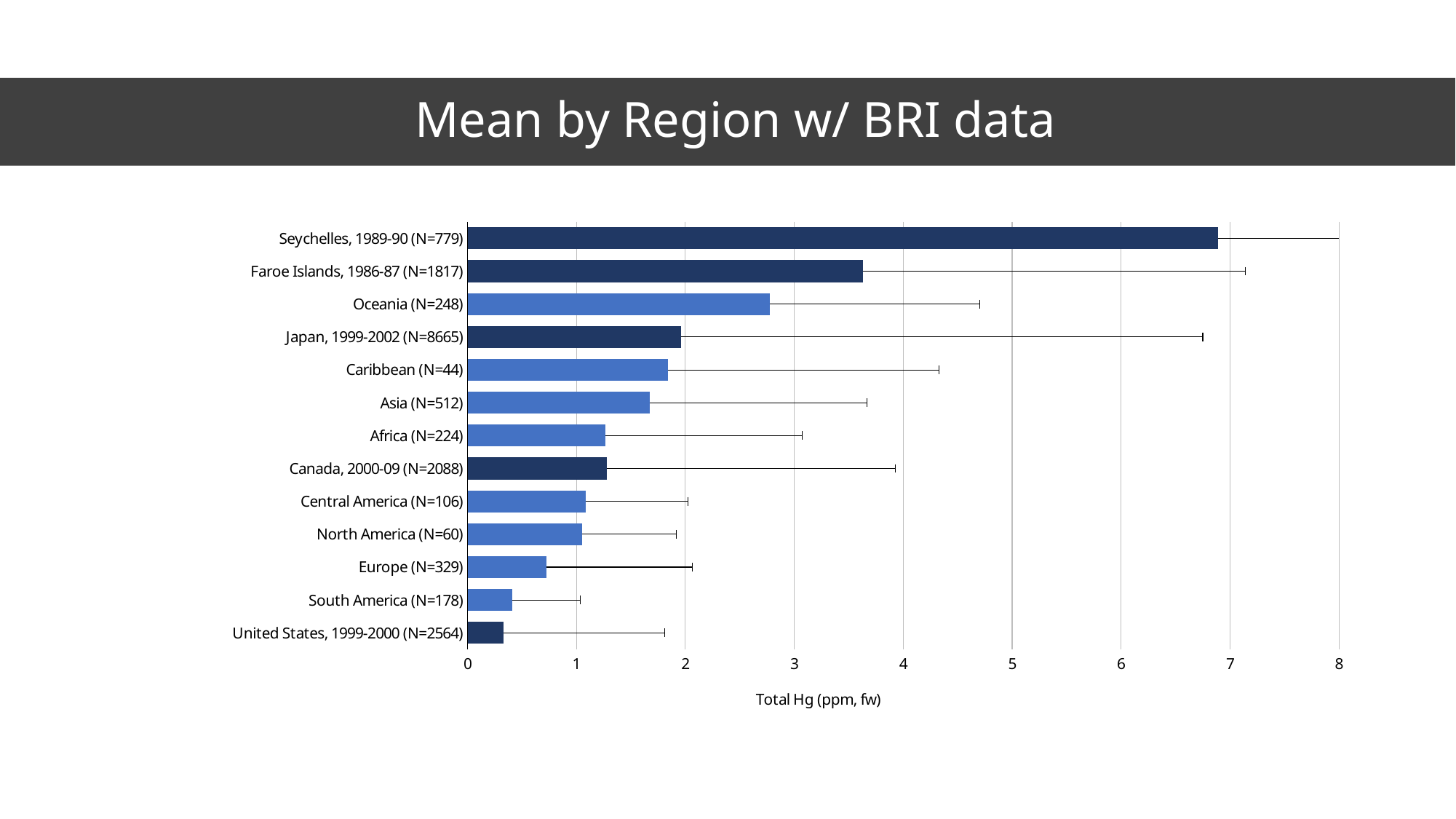
Which region has the lowest mean Total Hg? United States, 1999-2000 (N=2564) What kind of chart is shown on the slide? bar chart Is the value for Asia (N=512) greater or less than 1? greater Is the value for Oceania (N=248) greater or less than 3? less Which has a larger mean Total Hg, Europe (N=329) or South America (N=178)? Europe (N=329) How many regions (bars) are plotted in the chart? 13 Which region has the highest mean Total Hg? Seychelles, 1989-90 (N=779) Which has a larger mean Total Hg, Oceania (N=248) or Japan, 1999-2002 (N=8665)? Oceania (N=248) Is the value for Faroe Islands, 1986-87 (N=1817) greater or less than 3? greater What is the label of the horizontal axis? Total Hg (ppm, fw)